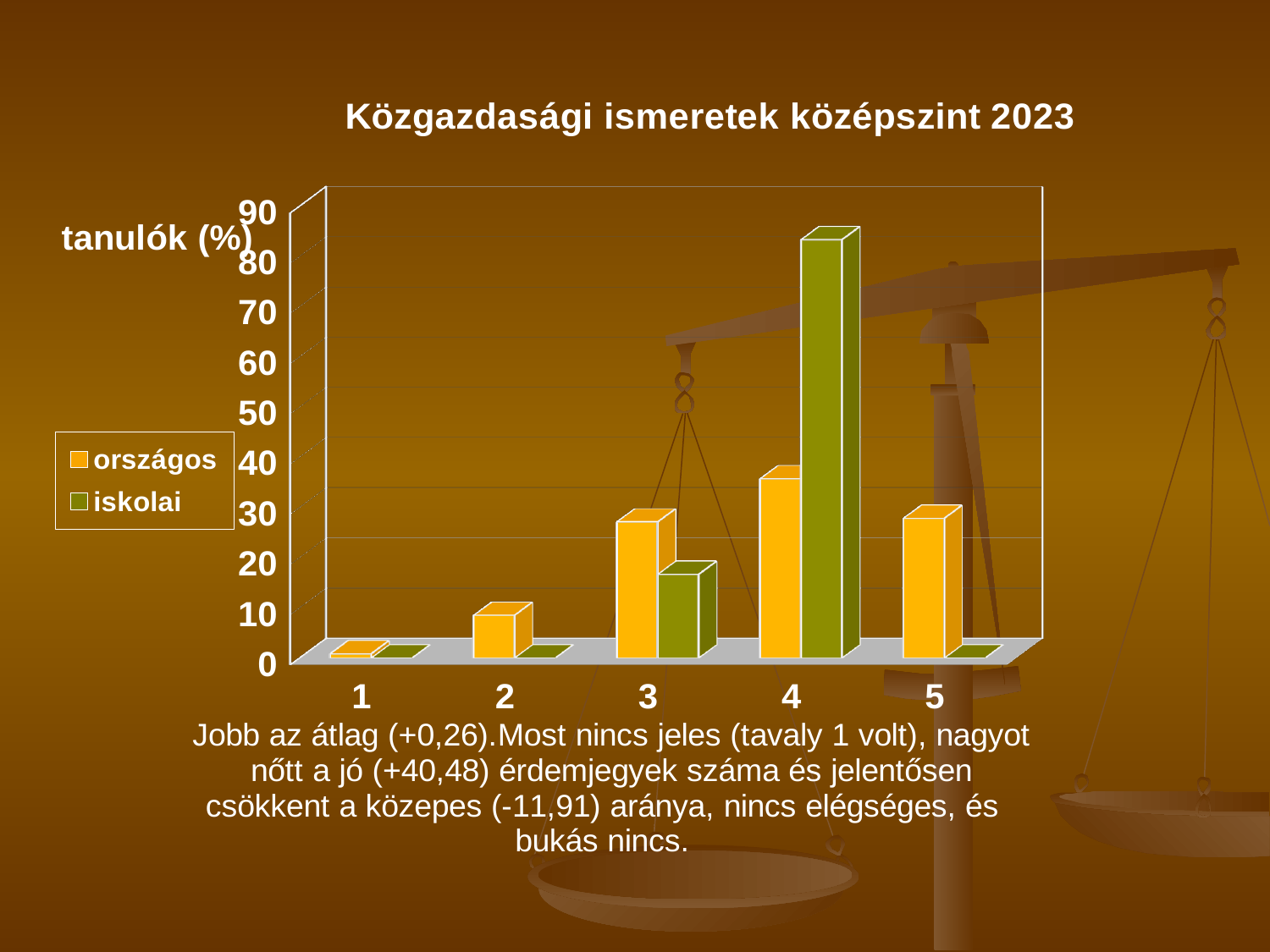
Which category has the lowest value for the országos series? 1 What is the title of the chart? Közgazdasági ismeretek középszint 2023 How many categories are shown on the x axis? 5 Is the országos value for category 2 greater or less than 20? less What kind of chart is shown on the slide? bar chart For category 3, which series has the larger value, országos or iskolai? országos Is the iskolai value for category 4 greater or less than 70? greater How many series does the legend list? 2 For category 4, which series has the larger value, országos or iskolai? iskolai Which category has the highest value for the országos series? 4 Which category has the highest value for the iskolai series? 4 Is the országos value for category 4 greater or less than 30? greater